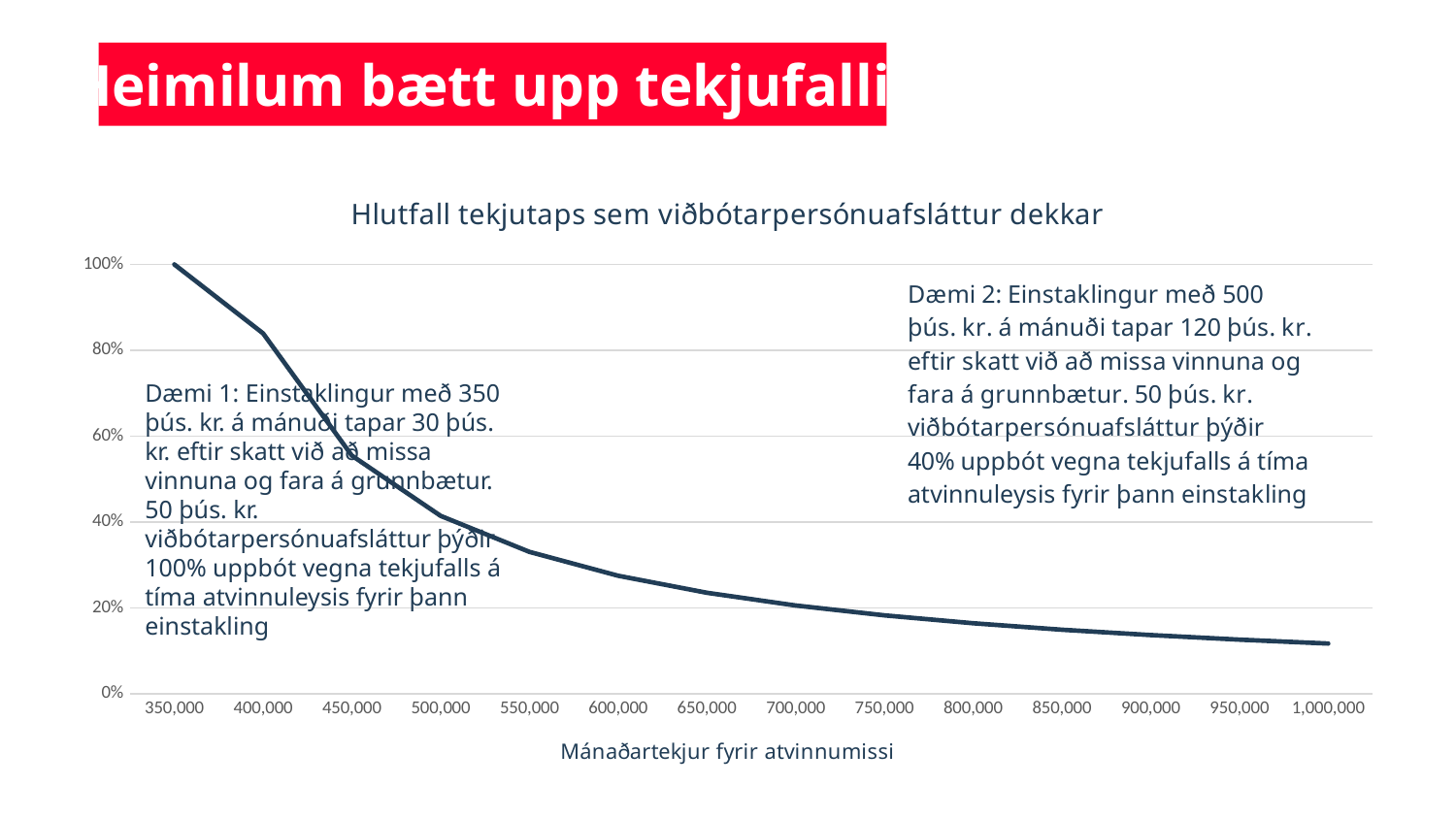
What is the value at a monthly income of 350,000? 100% Is the value for 600,000 greater or less than 40%? less Is the value for 400,000 greater or less than 80%? greater At which monthly income is the plotted value lowest? 1,000,000 At which monthly income is the plotted value highest? 350,000 How many income values are labelled on the x axis? 14 Which has the larger value, 400,000 or 600,000? 400,000 What is the title of the chart? Hlutfall tekjutaps sem viðbótarpersónuafsláttur dekkar Is the value for 1,000,000 greater or less than 20%? less What kind of chart is shown on the slide? line chart What is the label of the x axis? Mánaðartekjur fyrir atvinnumissi Do the values rise or fall as monthly income increases along the x axis? fall